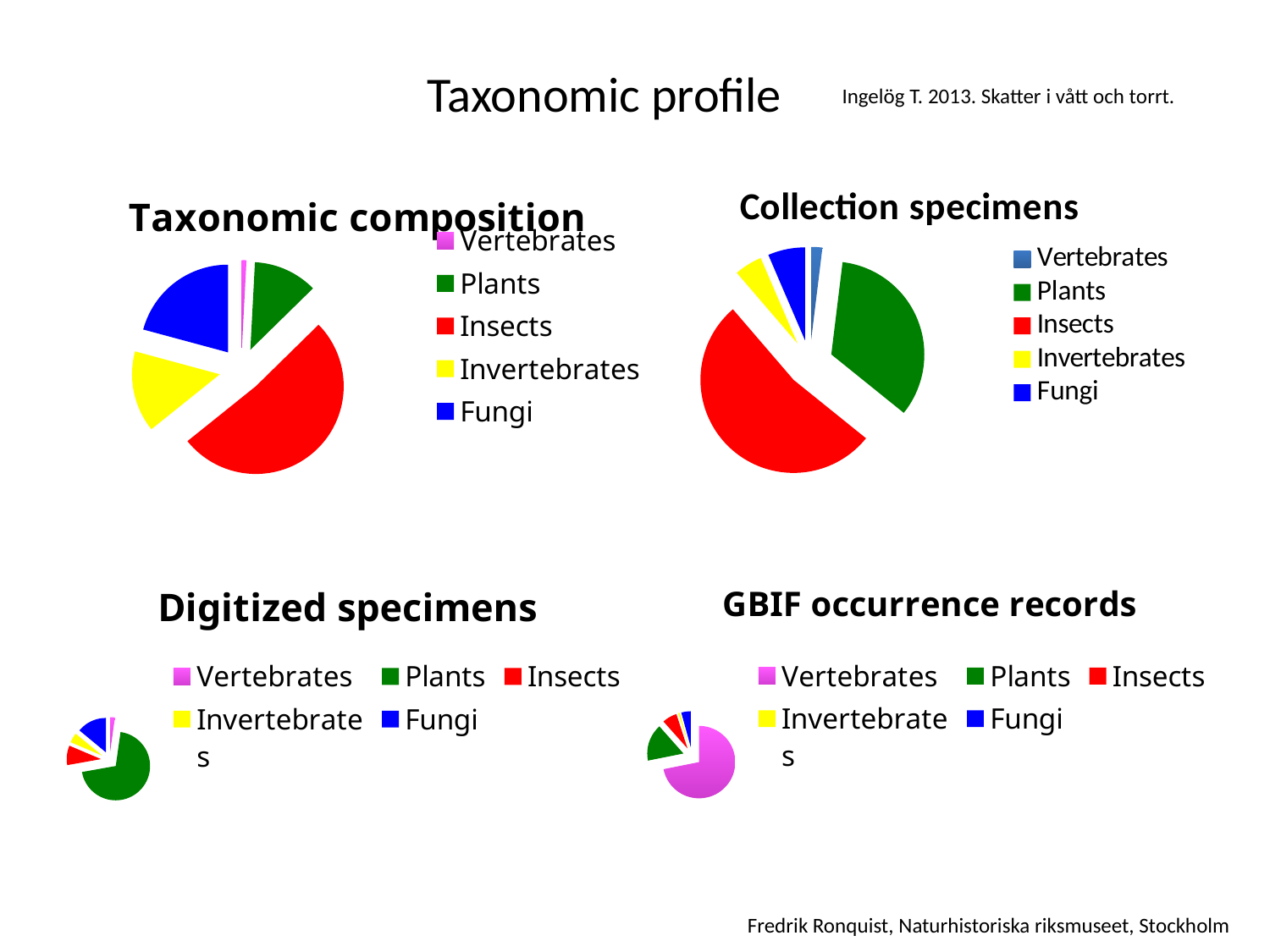
In the "Taxonomic composition" chart, which category has the smallest slice? Vertebrates In the "Taxonomic composition" chart, which slice is larger, Fungi or Plants? Fungi In the "Taxonomic composition" chart, which category has the largest slice? Insects How many categories does the legend of the "Collection specimens" chart list? 5 In the "Collection specimens" chart, which category has the smallest slice? Vertebrates In the "Digitized specimens" chart, which category has the largest slice? Plants What kind of chart is the "Taxonomic composition" chart? pie chart In the "GBIF occurrence records" chart, which category has the largest slice? Vertebrates In the "Collection specimens" chart, which slice is larger, Plants or Fungi? Plants How many pie charts are shown on the slide? 4 What colour represents Insects in the "Taxonomic composition" chart? red